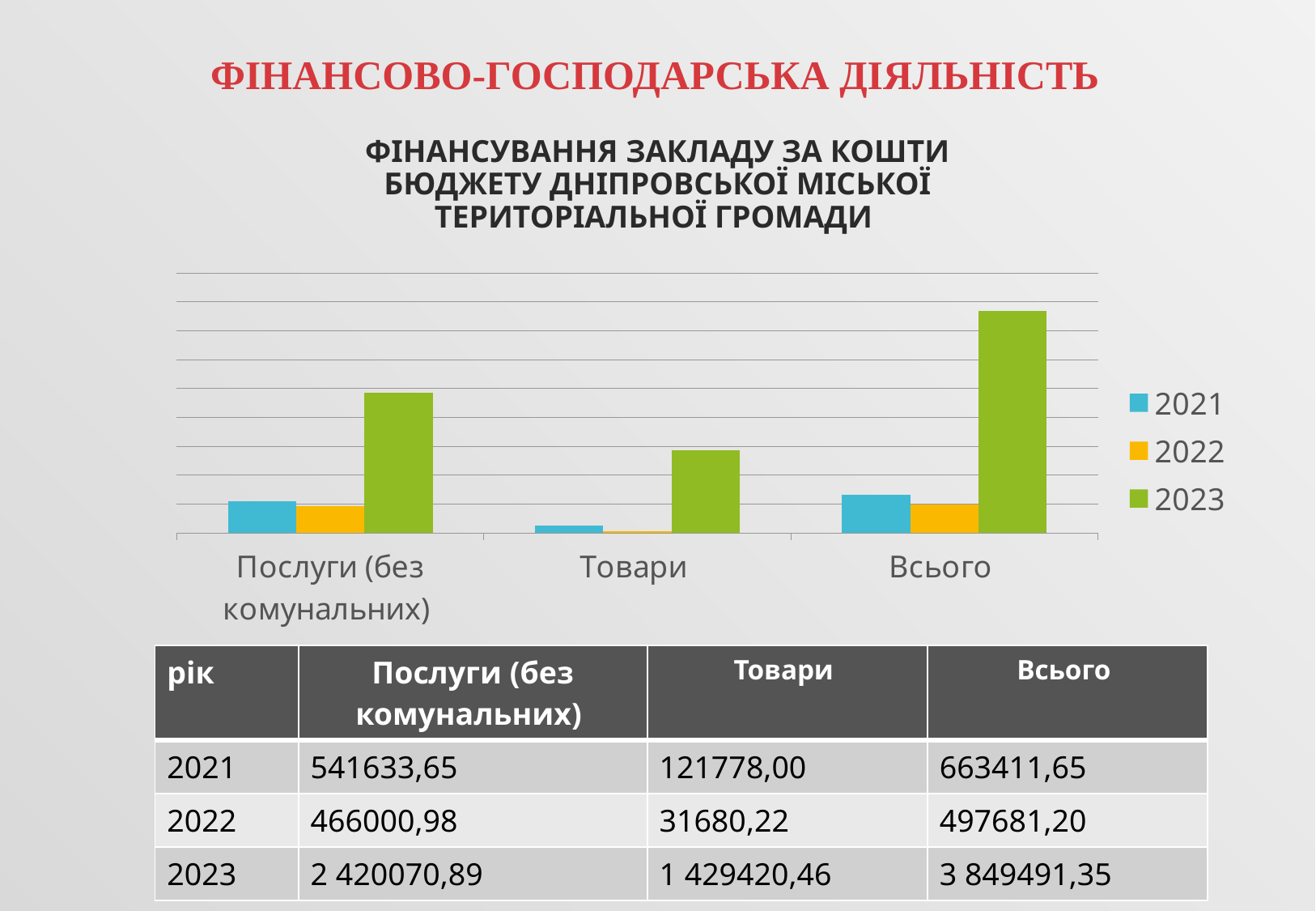
Which series in the legend is shown in green? 2023 According to the table on the slide, what is the value for Всього in 2021? 663411,65 How many categories are shown on the x axis of the chart? 3 According to the table on the slide, what is the value for Товари in 2023? 1 429420,46 Which category has the tallest 2023 bar in the chart? Всього Which year has the highest bar in the Всього category? 2023 In the Послуги (без комунальних) category, is the bar for 2021 or 2022 taller? 2021 What kind of chart is shown on the slide? bar chart Which year has the lowest bar in the Товари category? 2022 Which series in the legend is shown in yellow? 2022 How many series does the chart legend list? 3 According to the table on the slide, what is the value for Послуги (без комунальних) in 2022? 466000,98